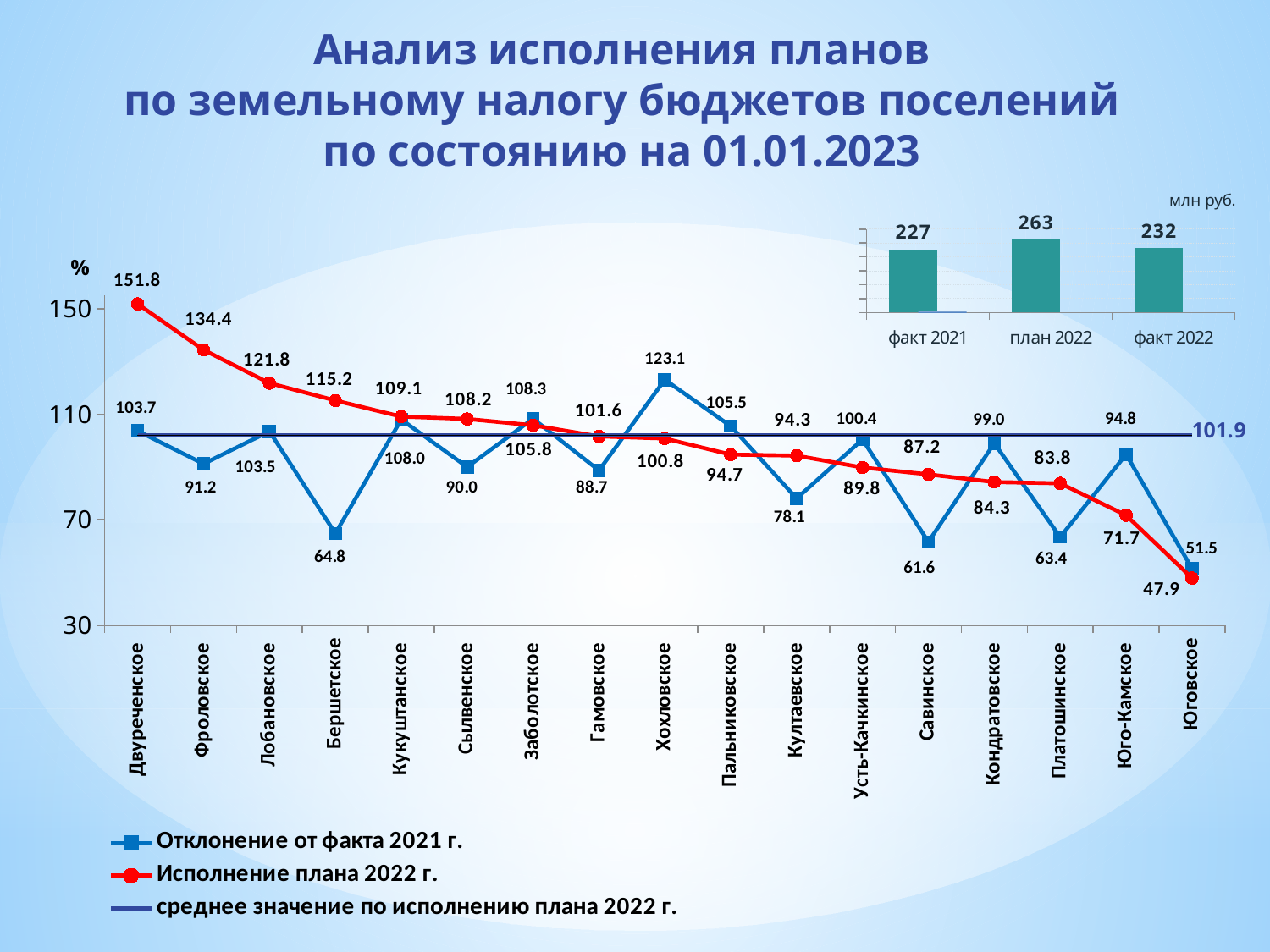
In the main line chart, what is the value of the среднее значение по исполнению плана 2022 г. line? 101.9 In the main line chart, which settlement has the lowest value of Исполнение плана 2022 г.? Юговское In the main line chart, how many series does the legend list? 3 In the main line chart, what is the value of Исполнение плана 2022 г. for Двуреченское? 151.8 In the small bar chart at the top right, what kind of chart is it? bar chart In the main line chart, for Бершетское, which is larger: Отклонение от факта 2021 г. or Исполнение плана 2022 г.? Исполнение плана 2022 г. In the small bar chart at the top right, what is the value for план 2022? 263 In the main line chart, what is the value of Отклонение от факта 2021 г. for Хохловское? 123.1 In the main line chart, how many settlements are shown on the x axis? 17 In the small bar chart at the top right, what is the difference between план 2022 and факт 2022? 31 In the small bar chart at the top right, which category has the highest value? план 2022 In the main line chart, does the Исполнение плана 2022 г. series rise or fall from left to right? fall